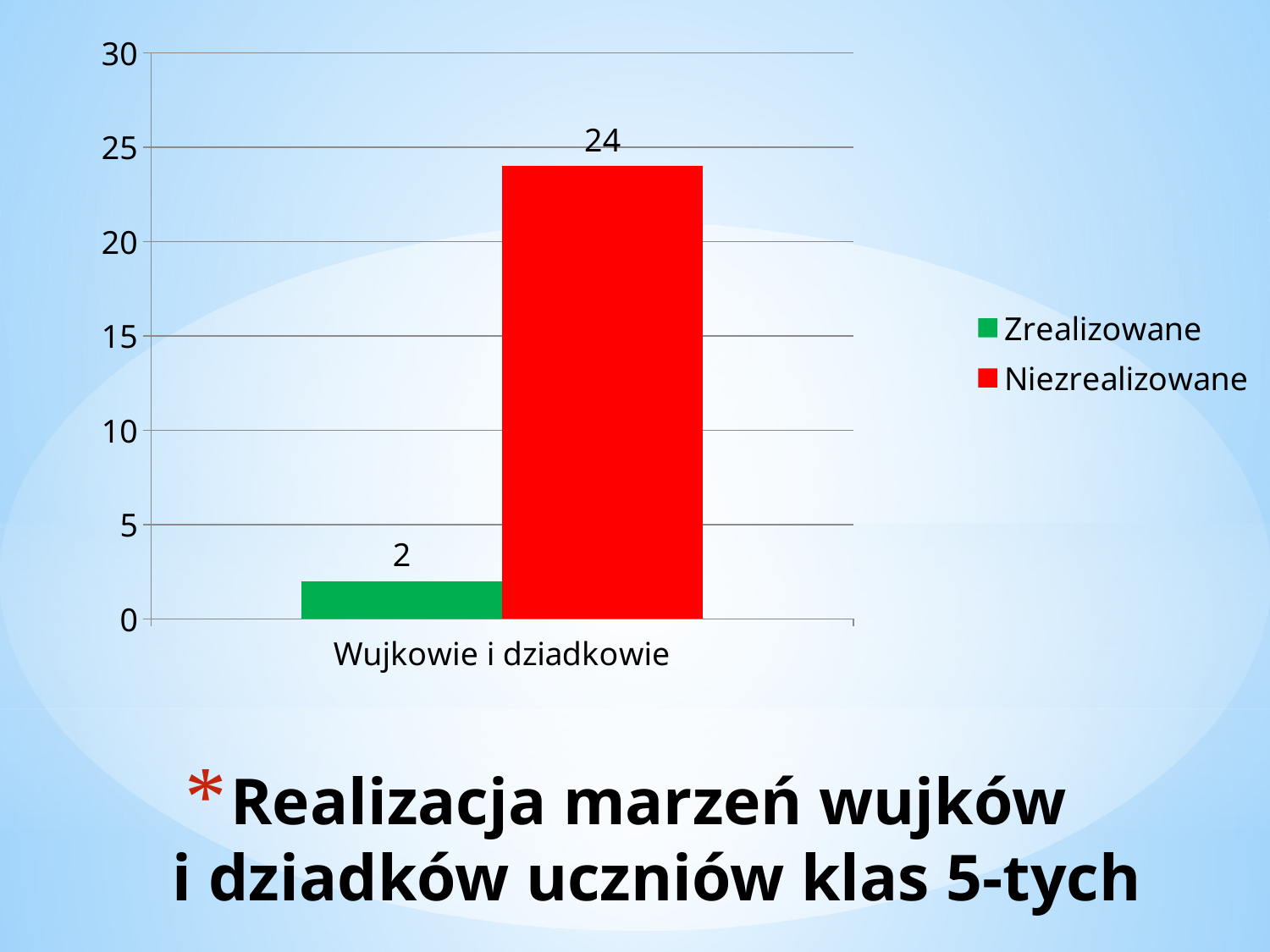
What is the value of the Niezrealizowane bar for Wujkowie i dziadkowie? 24 Is the Zrealizowane value greater or less than 5? less How many series does the legend list? 2 What kind of chart is shown on the slide? bar chart What is the total of the Zrealizowane and Niezrealizowane values? 26 How many categories are shown on the x axis? 1 Which series has the lower value: Zrealizowane or Niezrealizowane? Zrealizowane Which series has the higher value: Zrealizowane or Niezrealizowane? Niezrealizowane Is the Niezrealizowane value greater or less than 20? greater What is the difference between the Niezrealizowane and Zrealizowane values? 22 What is the value of the Zrealizowane bar for Wujkowie i dziadkowie? 2 What colour is the Niezrealizowane bar? red